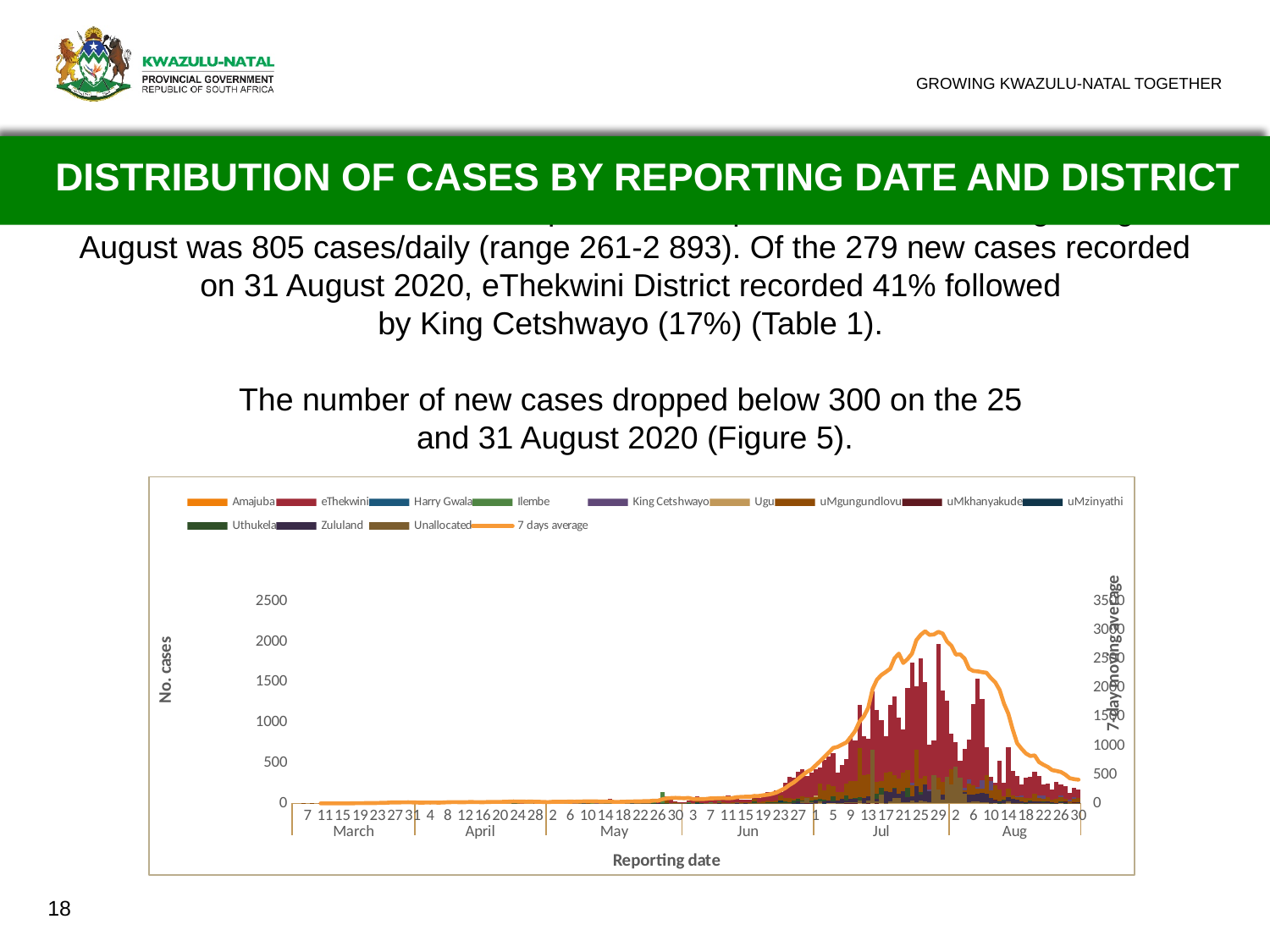
How many months are labelled along the x axis of the chart? 6 Which month on the x axis has the lowest bars? March Are the daily case bars in April greater or less than 500? less How many entries does the chart legend list? 13 What kind of chart is shown on the slide? Stacked bar chart with a line for the 7 days average Is the peak of the 7 days average line greater or less than 2500 on the right axis? greater What is the title of the left y axis of the chart? No. cases Which district series makes up the largest part of the stacked bars in July? eThekwini Does the 7 days average line rise or fall from March to late July? Rise What is the title of the x axis of the chart? Reporting date Which month on the x axis contains the tallest bars? Jul Does the 7 days average line rise or fall from the end of July to the end of August? Fall